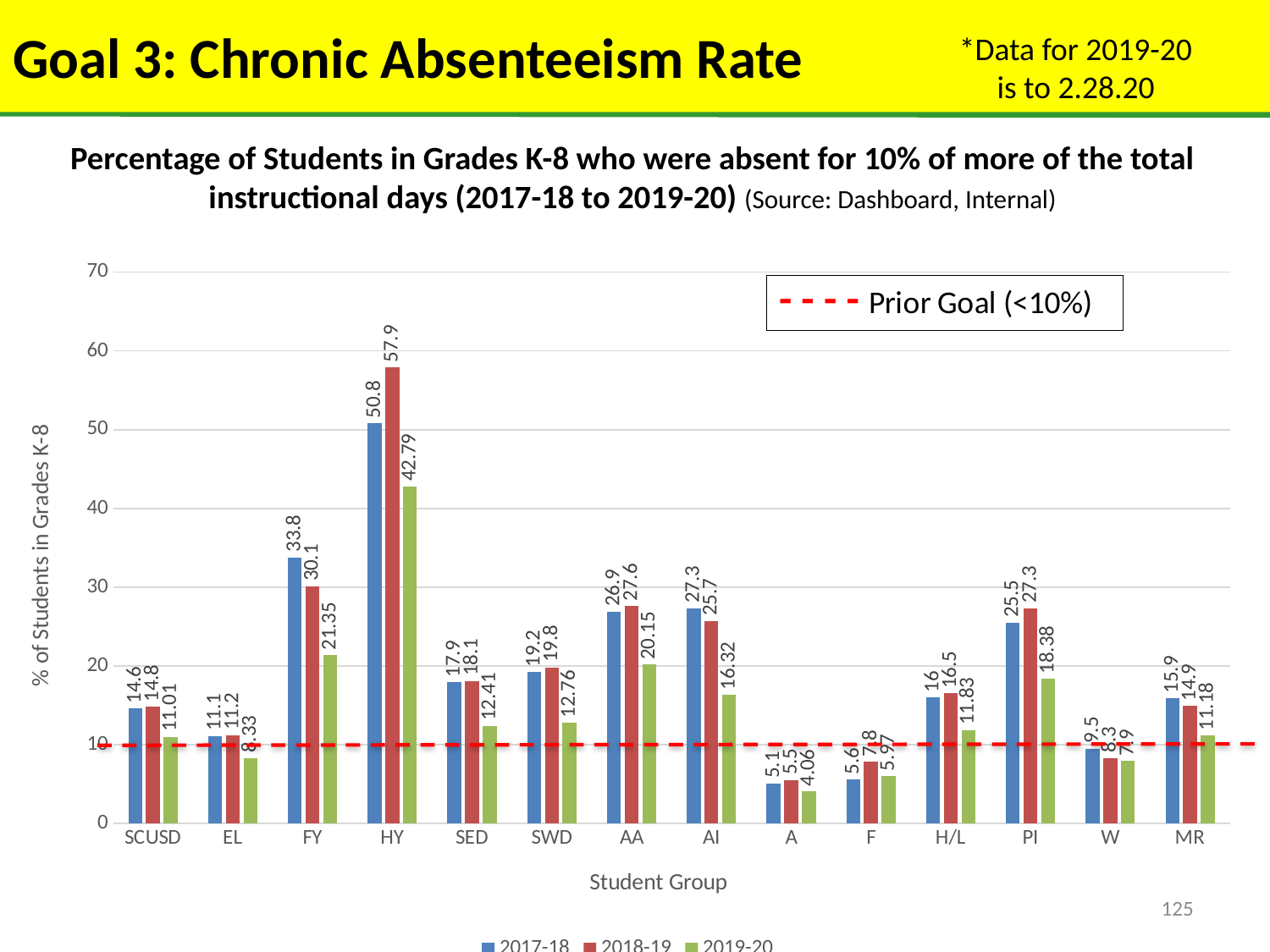
How many student groups are shown on the x axis? 14 What kind of chart is shown on the slide? Bar chart What is the 2018-19 value for HY? 57.9 Which student group has the lowest 2017-18 value? A Which is larger for PI: the 2017-18 value or the 2018-19 value? 2018-19 What is the 2017-18 value for AI? 27.3 What does the red dashed line on the chart represent? Prior Goal (<10%) What is the 2019-20 value for FY? 21.35 How many series does the legend list for the bars? 3 What is the difference between the 2017-18 and 2018-19 values for HY? 7.1 Is the 2019-20 value for HY greater or less than 40? greater Which student group has the highest 2019-20 value? HY